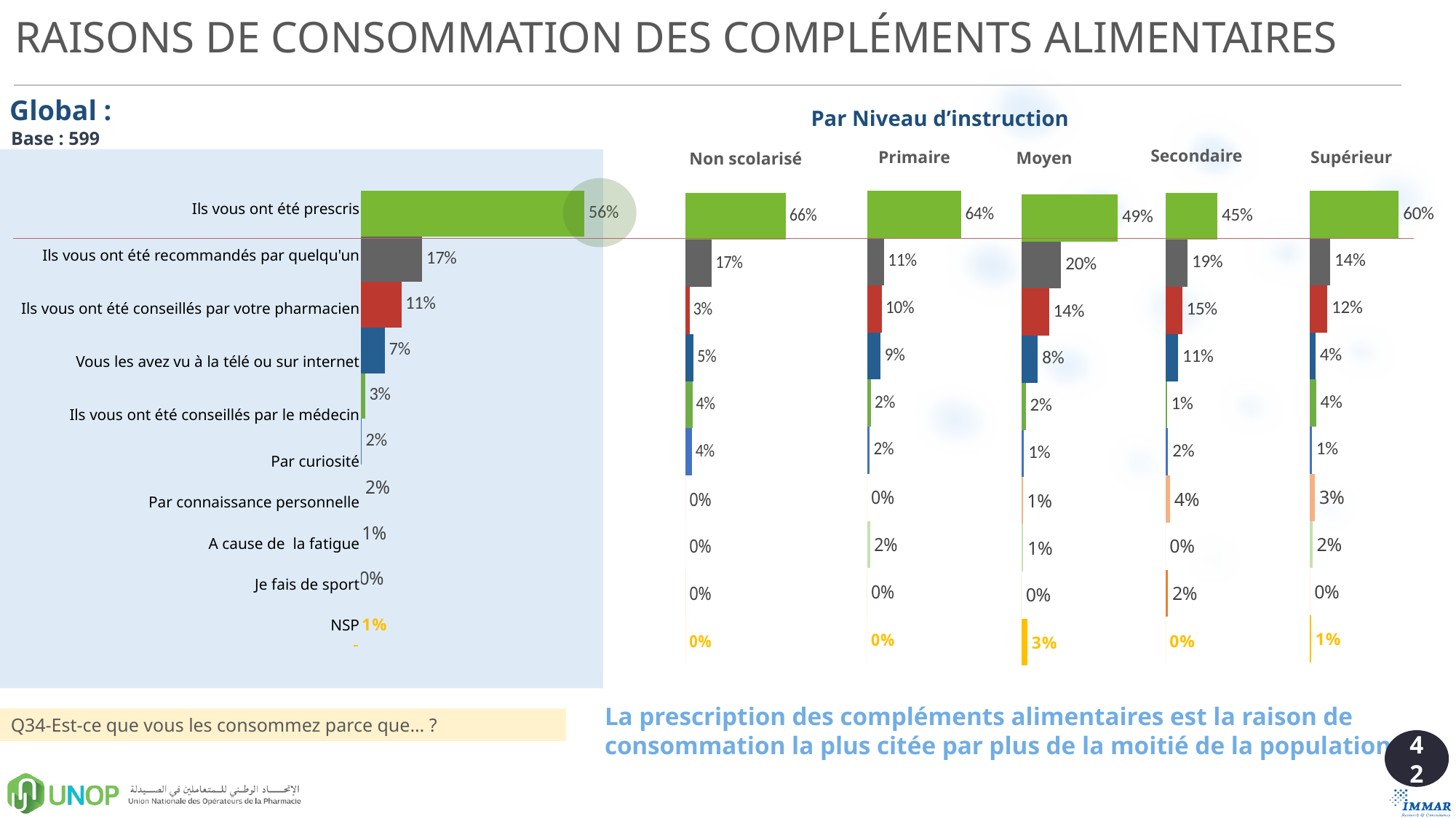
In the Global chart, how many reason categories are listed (including NSP)? 10 In the Global chart, what percentage is shown for "Ils vous ont été prescrits"? 56% What is the base (sample size) shown for the Global chart? 599 What kind of chart is the Global chart? Bar chart Which is larger for "Ils vous ont été conseillés par votre pharmacien": the Secondaire chart or the Non scolarisé chart? Secondaire In the Non scolarisé chart, what percentage is shown for "Ils vous ont été prescrits"? 66% Among the five education-level charts, which level has the lowest percentage for "Ils vous ont été prescrits"? Secondaire In the Global chart, which reason has the highest percentage? Ils vous ont été prescrits In the Moyen chart, what percentage is shown for "Ils vous ont été recommandés par quelqu'un"? 20% In the Global chart, what is the difference between "Ils vous ont été recommandés par quelqu'un" and "Vous les avez vu à la télé ou sur internet"? 10% In the Supérieur chart, what percentage is shown for NSP? 1% In the Global chart, what percentage is shown for "Ils vous ont été conseillés par votre pharmacien"? 11%